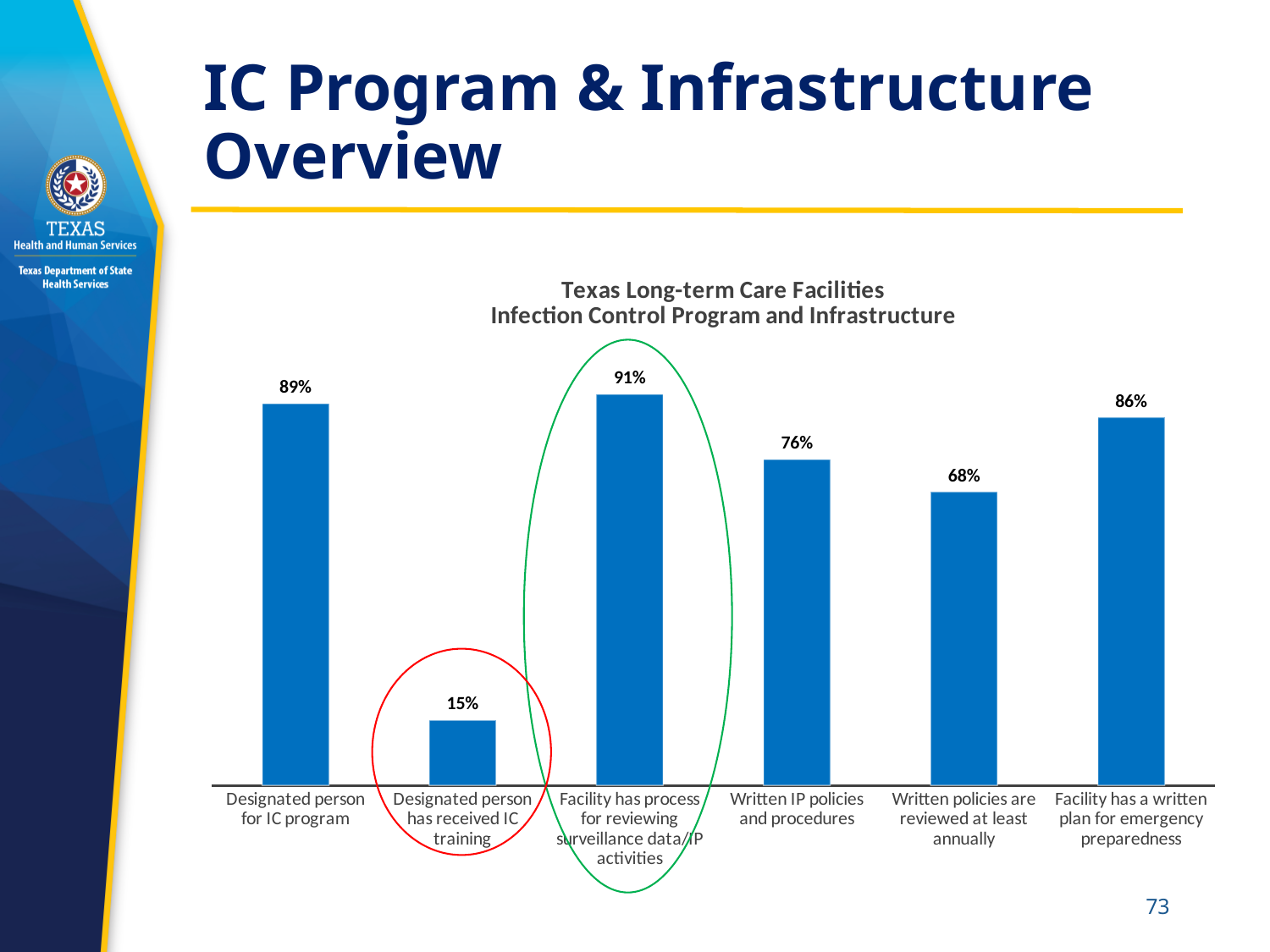
Which category has the highest value? Facility has process for reviewing surveillance data/IP activities What is the value for 'Designated person for IC program'? 89% How many categories are shown in the chart? 6 Which category has the lowest value? Designated person has received IC training Which is larger: 'Written IP policies and procedures' or 'Facility has a written plan for emergency preparedness'? Facility has a written plan for emergency preparedness What is the difference between 'Designated person for IC program' and 'Designated person has received IC training'? 74% What is the value for 'Written policies are reviewed at least annually'? 68% What is the value for 'Designated person has received IC training'? 15% What is the value for 'Facility has a written plan for emergency preparedness'? 86% What is the title of the chart? Texas Long-term Care Facilities Infection Control Program and Infrastructure What is the difference between 'Written IP policies and procedures' and 'Written policies are reviewed at least annually'? 8% What kind of chart is shown on the slide? Bar chart